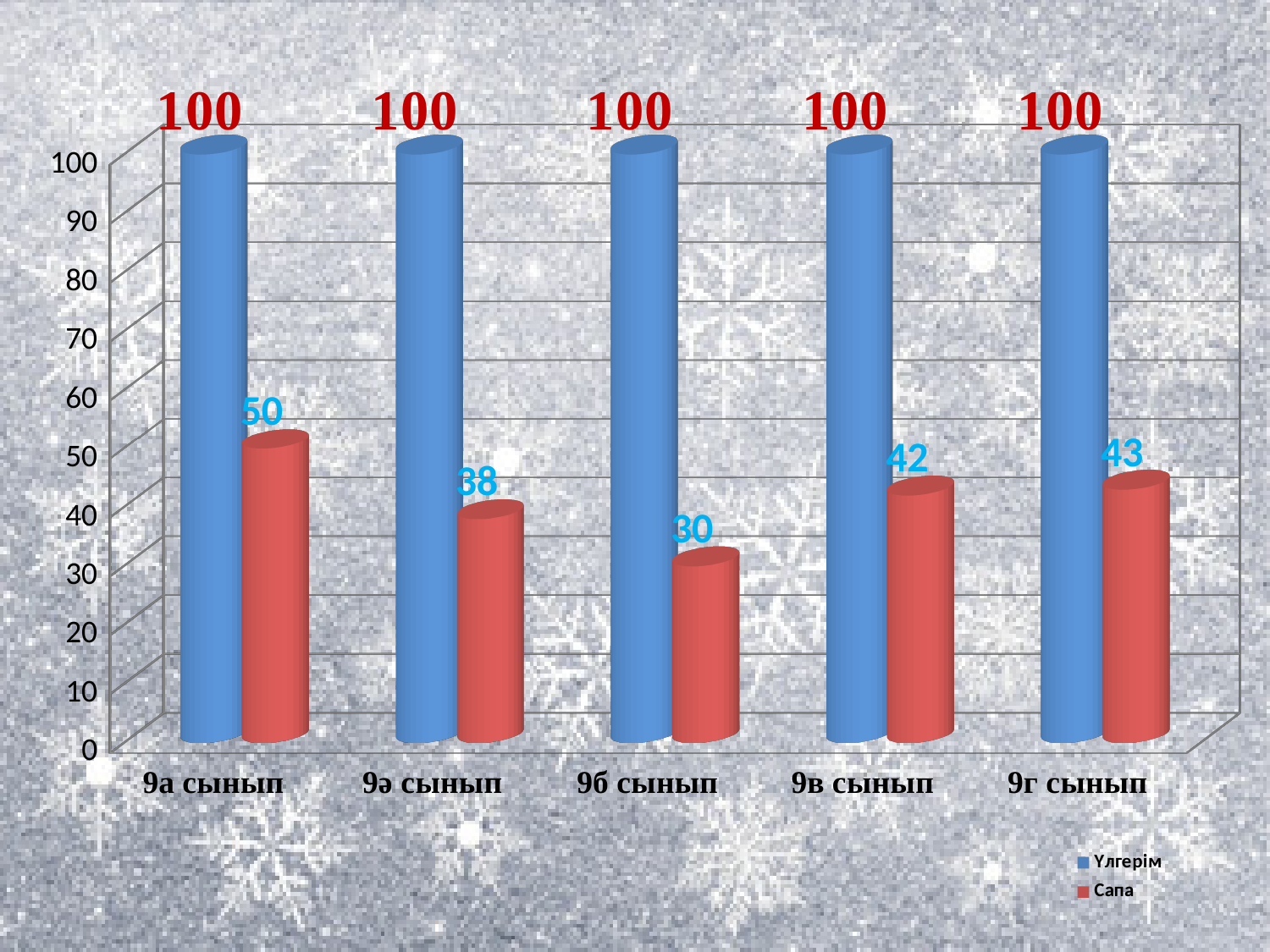
What is the difference between the Сапа values for 9а сынып and 9б сынып? 20 What is the Сапа value for 9б сынып? 30 What is the Үлгерім value for 9в сынып? 100 What is the Сапа value for 9а сынып? 50 Which is larger, the Сапа value for 9в сынып or for 9ә сынып? 9в сынып How many series does the legend list? 2 Which class has the lowest Сапа value? 9б сынып What is the difference between the Үлгерім and Сапа values for 9ә сынып? 62 Which class has the highest Сапа value? 9а сынып What kind of chart is shown on the slide? Bar chart How many classes are shown on the x axis? 5 Which series is shown in red? Сапа